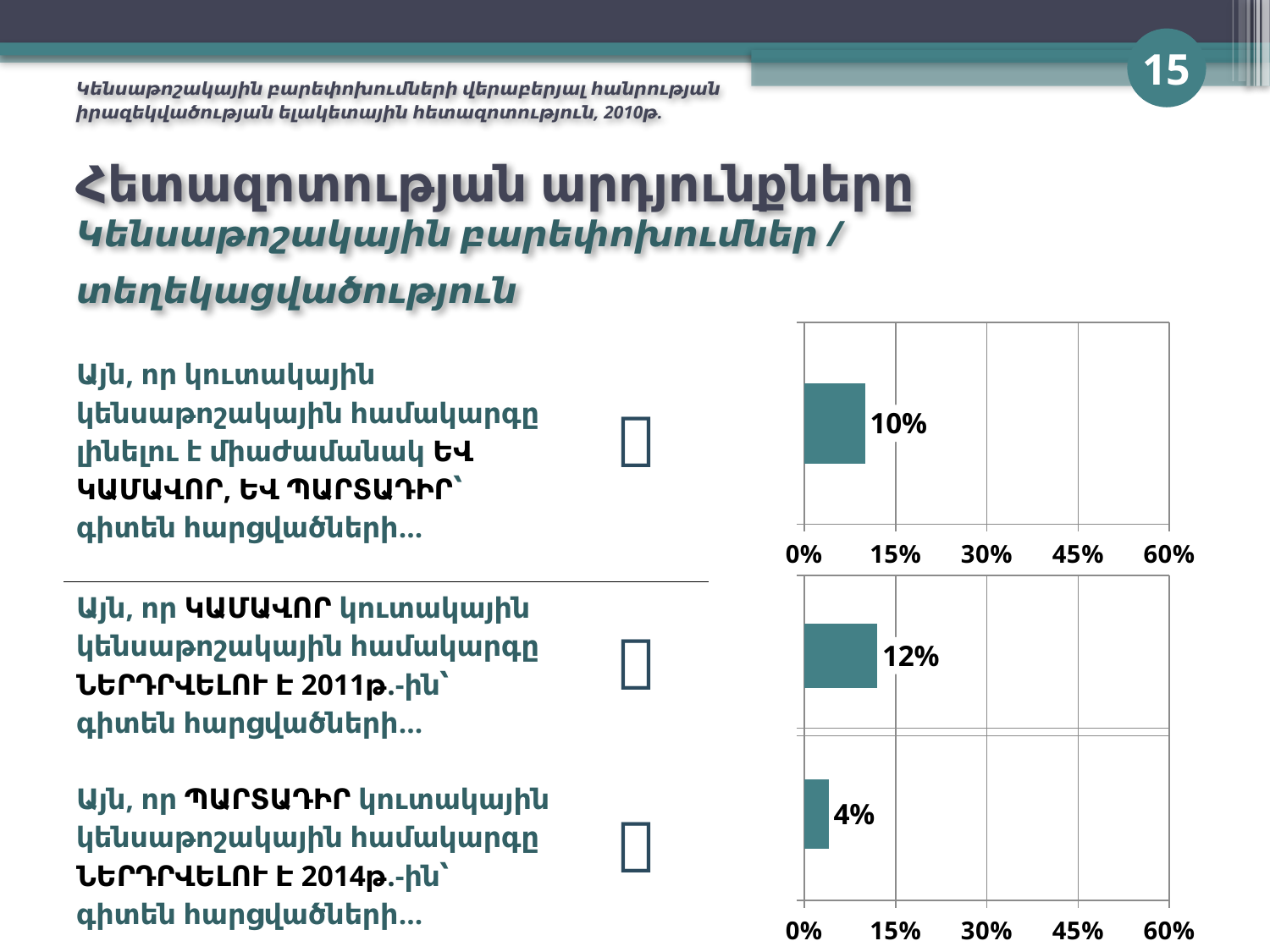
What is the maximum value shown on the horizontal axis of the charts on the right side of the slide? 60% What value is shown on the middle bar (second from top) of the charts on the right side of the slide? 12% Is the value of the middle bar on the right side of the slide greater or less than 15%? less What value is shown on the bottom bar of the charts on the right side of the slide? 4% Among the three bars on the right side of the slide, which bar has the lowest value? the bottom bar (4%) Among the three bars on the right side of the slide, which bar has the highest value? the middle bar (12%) What is the difference between the middle bar (12%) and the bottom bar (4%) on the right side of the slide? 8% How many bars in total are plotted on the right side of the slide? 3 What value is shown on the top bar of the charts on the right side of the slide? 10% What kind of chart is shown on the right side of the slide? bar chart Which is larger on the right side of the slide: the top bar or the bottom bar? the top bar (10%) What is the difference between the middle bar (12%) and the top bar (10%) on the right side of the slide? 2%